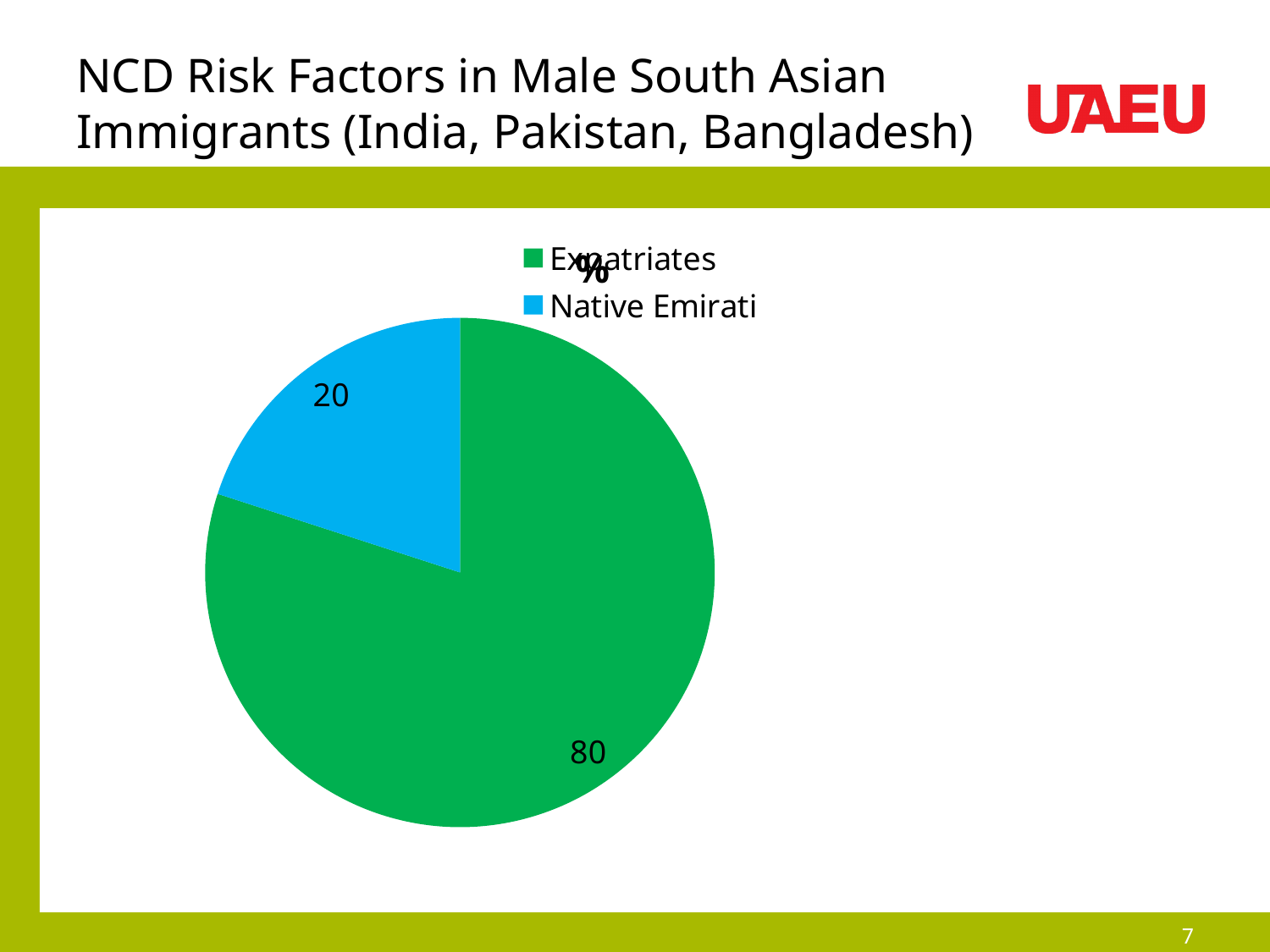
Which category has the largest slice of the pie chart? Expatriates What kind of chart is shown on the slide? pie chart What is the value for Expatriates in the pie chart? 80 What is the difference between the values for Expatriates and Native Emirati? 60 What is the value for Native Emirati in the pie chart? 20 Which category has the smallest slice of the pie chart? Native Emirati What colour is the Native Emirati slice in the pie chart? blue How many slices does the pie chart have? 2 What share of the pie does the Expatriates slice represent? 80% What share of the pie does the Native Emirati slice represent? 20% Which is larger, the value for Expatriates or the value for Native Emirati? Expatriates How many entries does the legend of the pie chart list? 2